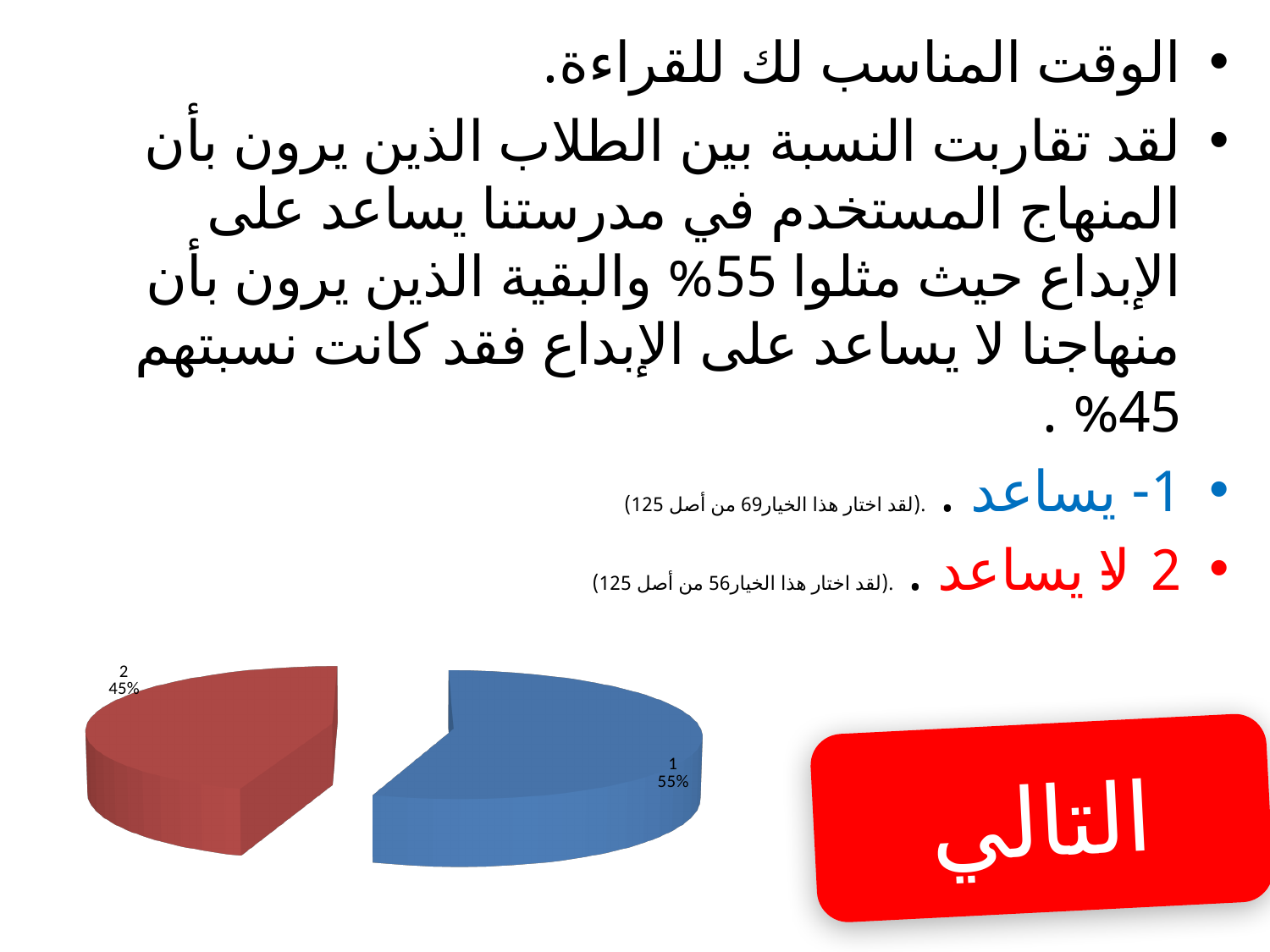
Which slice of the pie chart is the largest? 1 What share of the pie does slice 1 represent? 55% What is the difference in percentage points between slice 1 and slice 2 in the pie chart? 10 How many slices does the pie chart have? 2 What kind of chart is shown on the slide? pie chart What percentage is shown for slice 1 in the pie chart? 55% What colour is slice 2 in the pie chart? red What percentage is shown for slice 2 in the pie chart? 45% What colour is slice 1 in the pie chart? blue Which slice of the pie chart is the smallest? 2 Which slice is larger in the pie chart, slice 1 or slice 2? 1